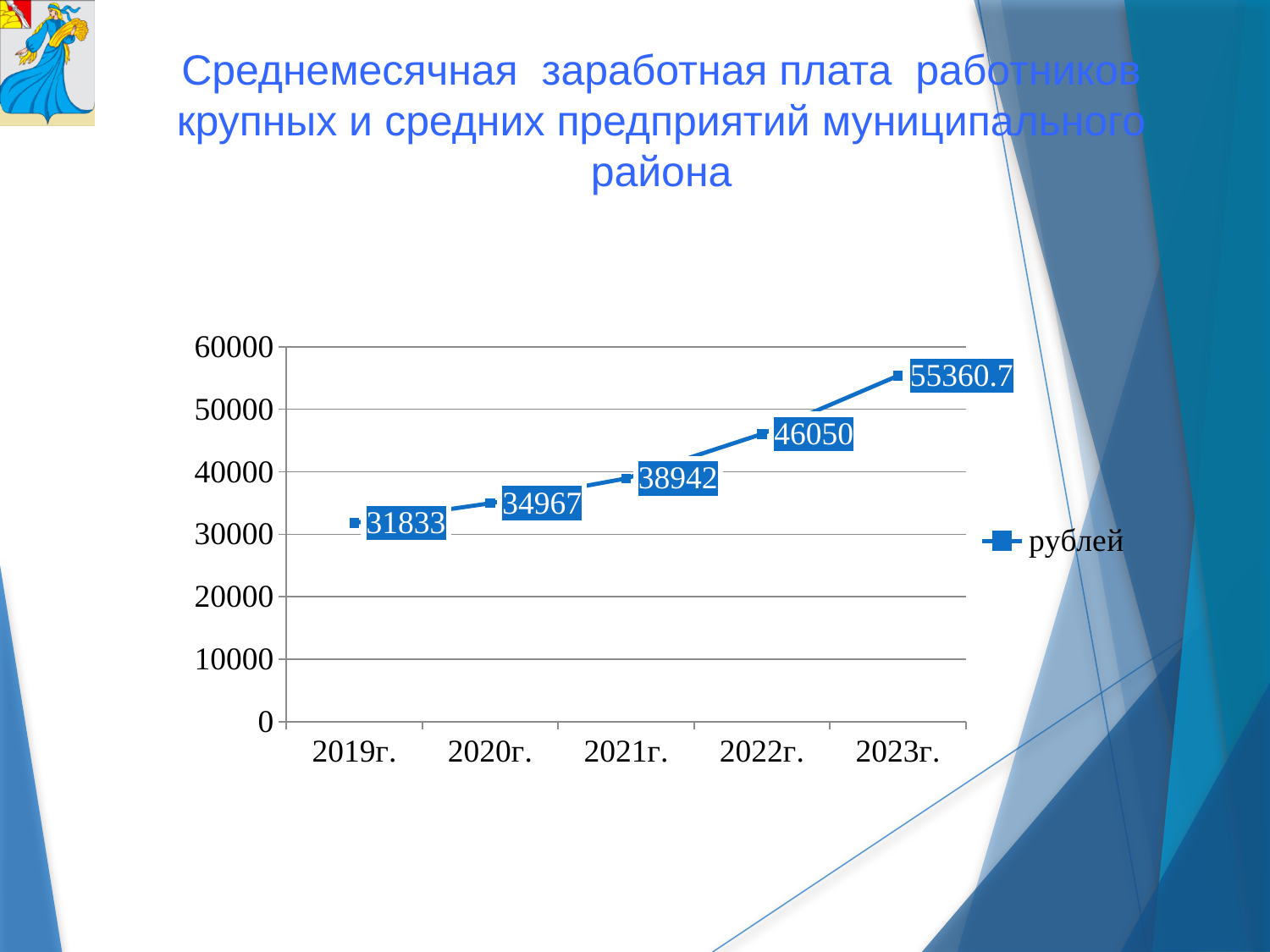
Which is larger, the value for 2020г. or the value for 2022г.? 2022г. Do the values rise or fall from 2019г. to 2023г.? rise What is the difference between the values for 2022г. and 2021г.? 7108 What is the value for 2021г.? 38942 What kind of chart is shown on the slide? line chart What is the value for 2023г.? 55360.7 Which year has the lowest value? 2019г. Which year has the highest value? 2023г. Is the value for 2022г. greater or less than 40000? greater What is the difference between the values for 2020г. and 2019г.? 3134 How many years are plotted on the chart? 5 What is the value for 2019г.? 31833